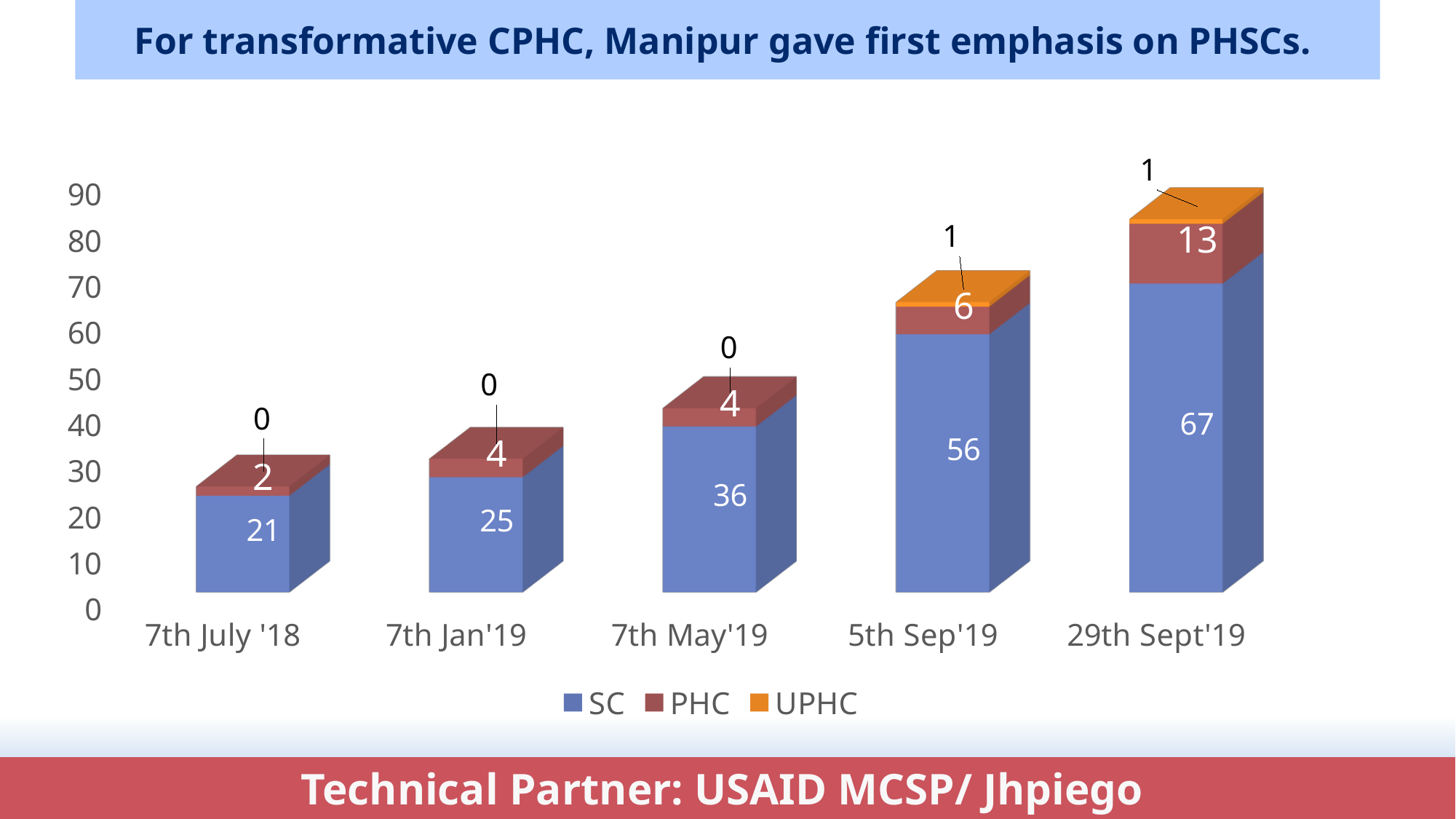
Do the SC values rise or fall from 7th July '18 to 29th Sept'19? Rise How many series does the legend list? 3 What is the PHC value for 7th May'19? 4 What is the difference between the SC values for 29th Sept'19 and 5th Sep'19? 11 What kind of chart is shown? Stacked bar chart How many dates are shown on the x axis? 5 Which date has the highest SC value? 29th Sept'19 Which is larger, the PHC value for 5th Sep'19 or the PHC value for 29th Sept'19? 29th Sept'19 Which date has the lowest SC value? 7th July '18 What is the SC value for 29th Sept'19? 67 What is the total of the stacked bar for 29th Sept'19? 81 What is the UPHC value for 5th Sep'19? 1